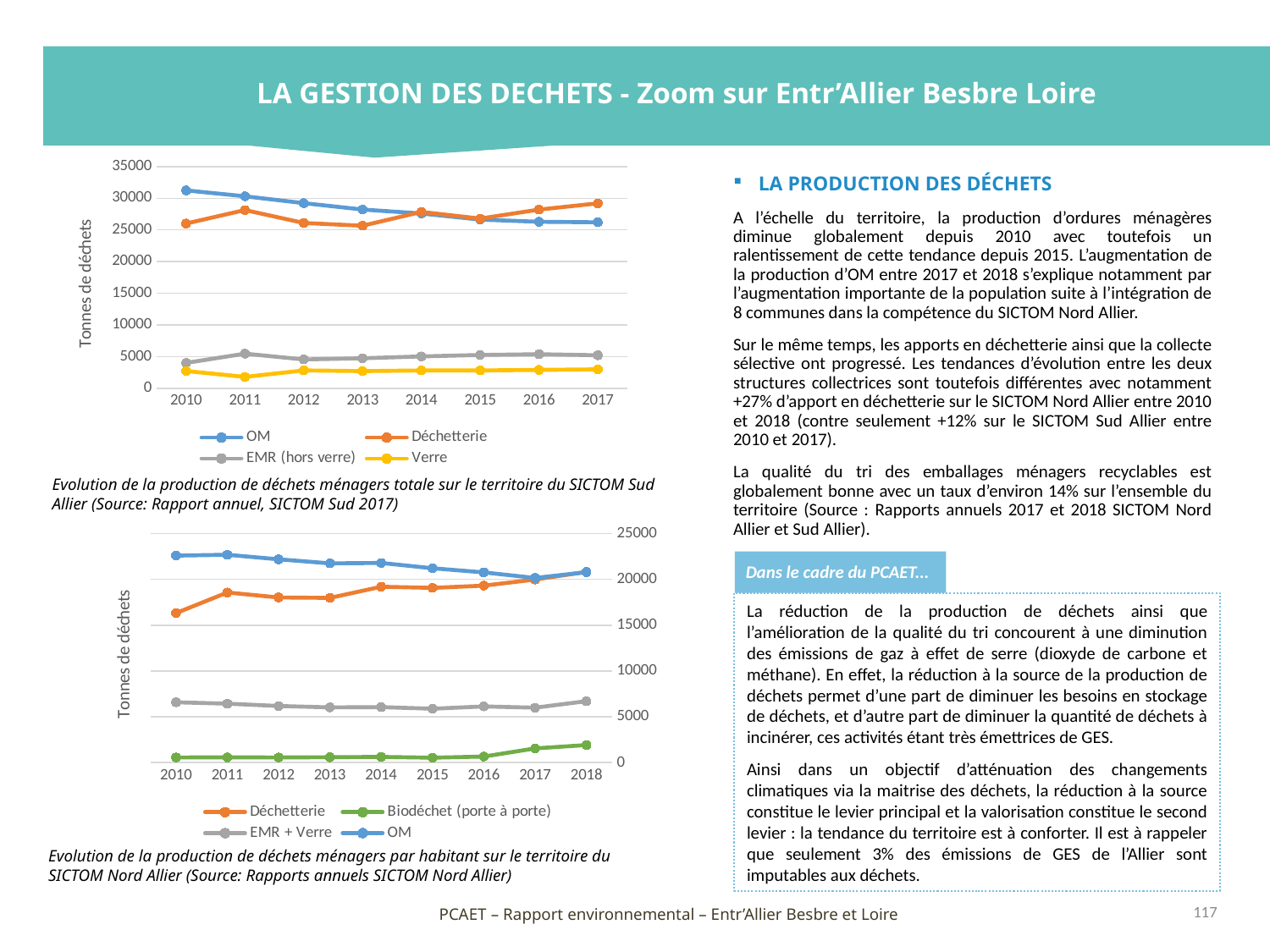
What type of chart is the top chart on the slide? Line chart How many years are shown on the x axis of the bottom chart (SICTOM Nord Allier)? 9 In the top chart (SICTOM Sud Allier), is the value for Verre in 2011 greater or less than 5000? less What is the y-axis label of the bottom chart (SICTOM Nord Allier)? Tonnes de déchets In the top chart (SICTOM Sud Allier), does the OM series rise or fall from 2010 to 2017? Fall In the bottom chart (SICTOM Nord Allier), does the Biodéchet (porte à porte) series rise or fall from 2016 to 2018? Rise In the top chart (SICTOM Sud Allier), which series is higher in 2017, OM or Déchetterie? Déchetterie In the top chart (SICTOM Sud Allier), which series has the lowest values across all years? Verre How many series does the legend of the top chart (SICTOM Sud Allier) list? 4 In the top chart (SICTOM Sud Allier), is the value for OM in 2010 greater or less than 30000? greater In the bottom chart (SICTOM Nord Allier), is the value for OM in 2010 greater or less than 20000? greater